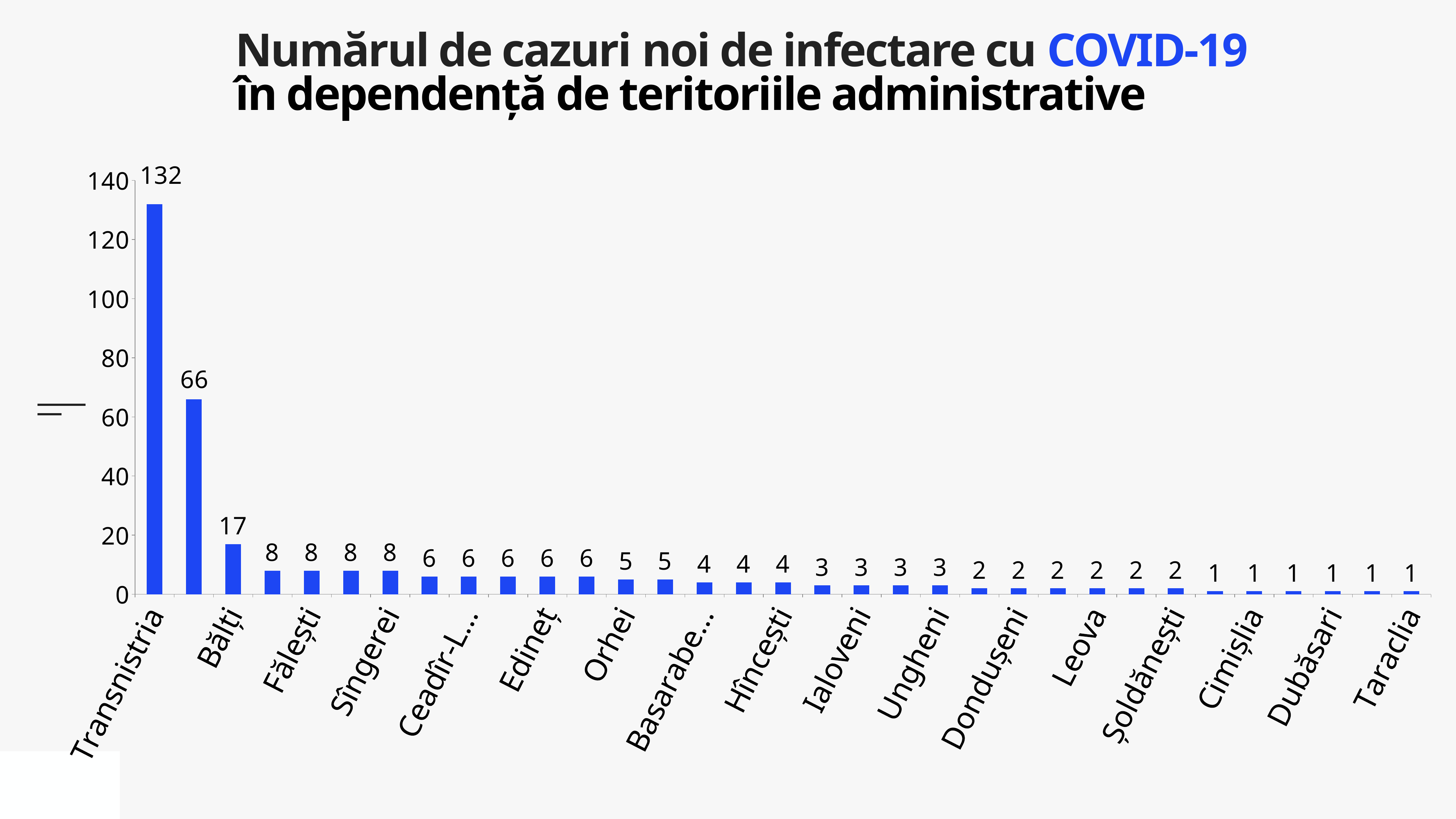
What is the value for Fălești? 8 What is the value for Taraclia? 1 What is the value for Leova? 2 What kind of chart is shown on the slide? bar chart What is the difference between the values for Transnistria and Fălești? 124 What is the value for Transnistria? 132 Which is larger, the value for Transnistria or the value for Orhei? Transnistria Which territory has the highest number of new cases? Transnistria Do the values rise or fall from left to right along the x axis? fall How many bars are plotted in the chart? 33 What is the value for Orhei? 5 Is the value for Transnistria greater or less than 120? greater